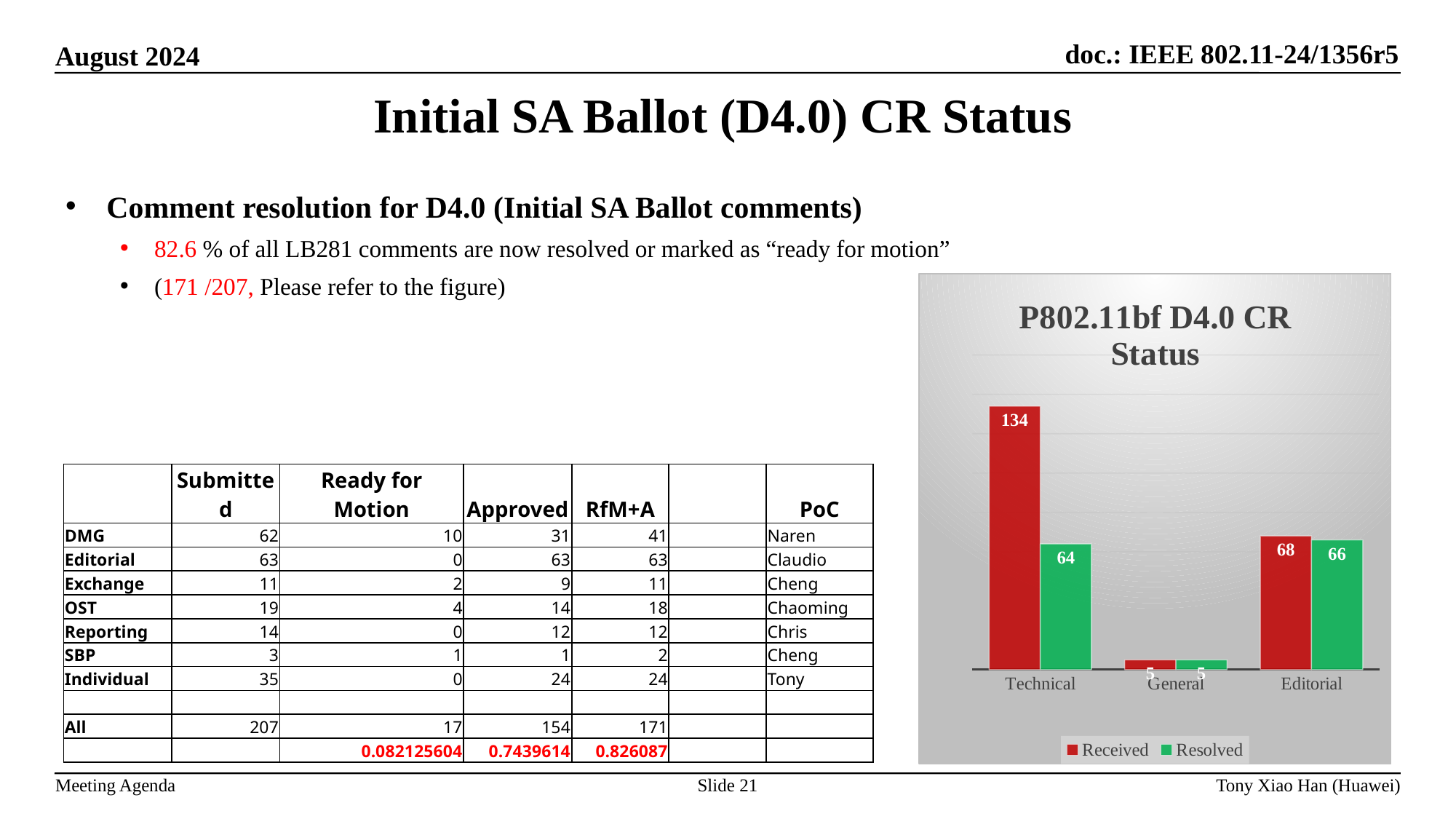
Which is larger, the Resolved value for Editorial or the Resolved value for Technical? Editorial What is the difference between the Received and Resolved values for Technical? 70 What is the title of the chart on the slide? P802.11bf D4.0 CR Status What is the Resolved value for General? 5 What is the Received value for Technical? 134 What is the Received value for Editorial? 68 Which category has the highest Received value? Technical What kind of chart is shown on the slide? bar chart How many categories are shown on the x axis of the chart? 3 How many series does the chart legend list? 2 Which category has the lowest Resolved value? General What is the Resolved value for Technical? 64